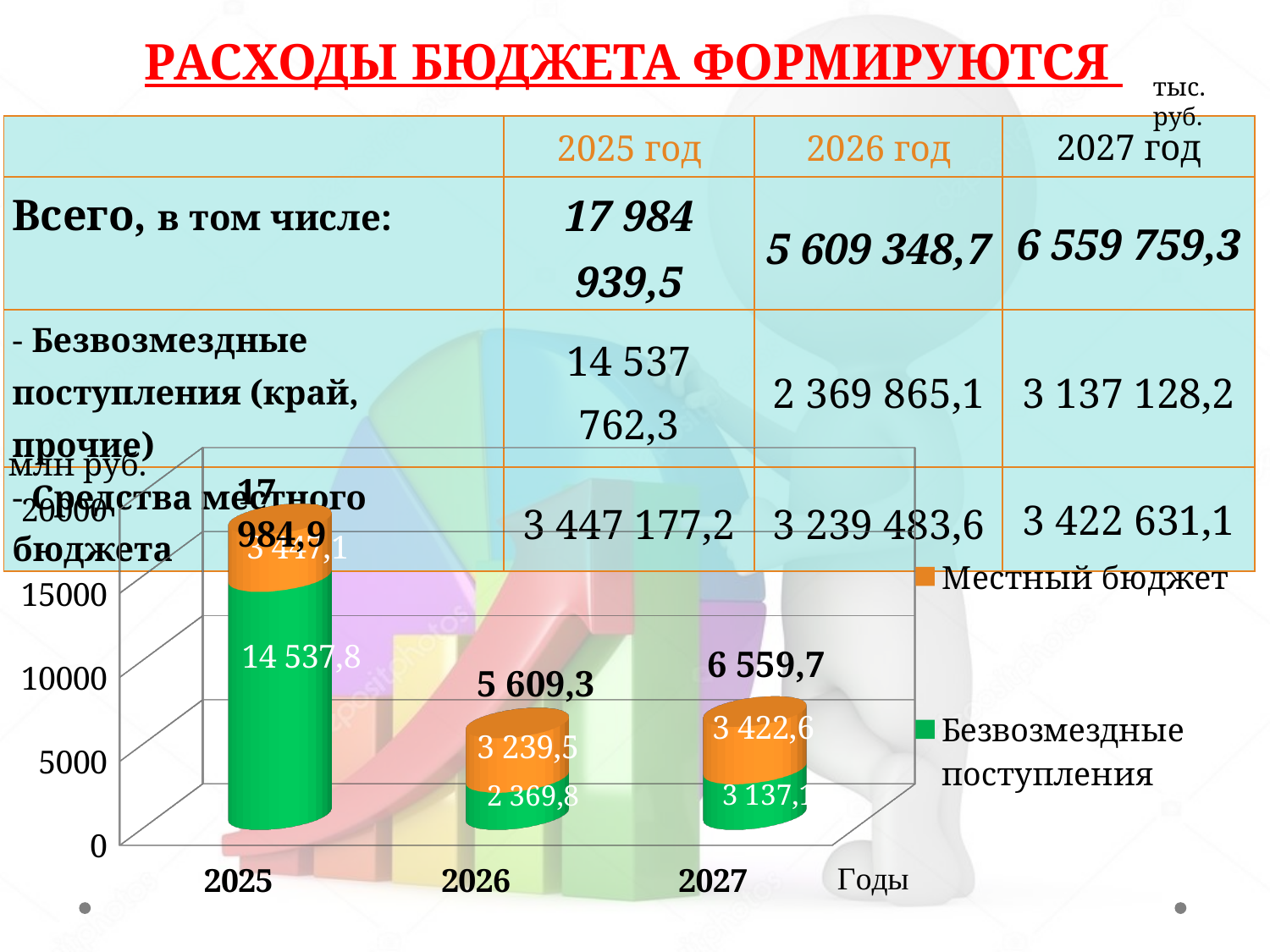
How many years are shown on the x axis of the chart? 3 In the chart, what is the value of Безвозмездные поступления for 2027? 3 137,1 In the chart, what is the value of Местный бюджет for 2026? 3 239,5 In the chart, is the total for 2025 greater or less than 15000? greater How many series does the chart legend list? 2 In the chart, what is the total of the stacked bar for 2026? 5 609,3 Which year has the highest total in the chart? 2025 In the chart, which is larger for 2027: Местный бюджет or Безвозмездные поступления? Местный бюджет What type of chart is shown on the slide? bar chart Which year has the lowest total in the chart? 2026 In the chart, what is the value of Безвозмездные поступления for 2025? 14 537,8 In the chart, what is the total of the stacked bar for 2027? 6 559,7